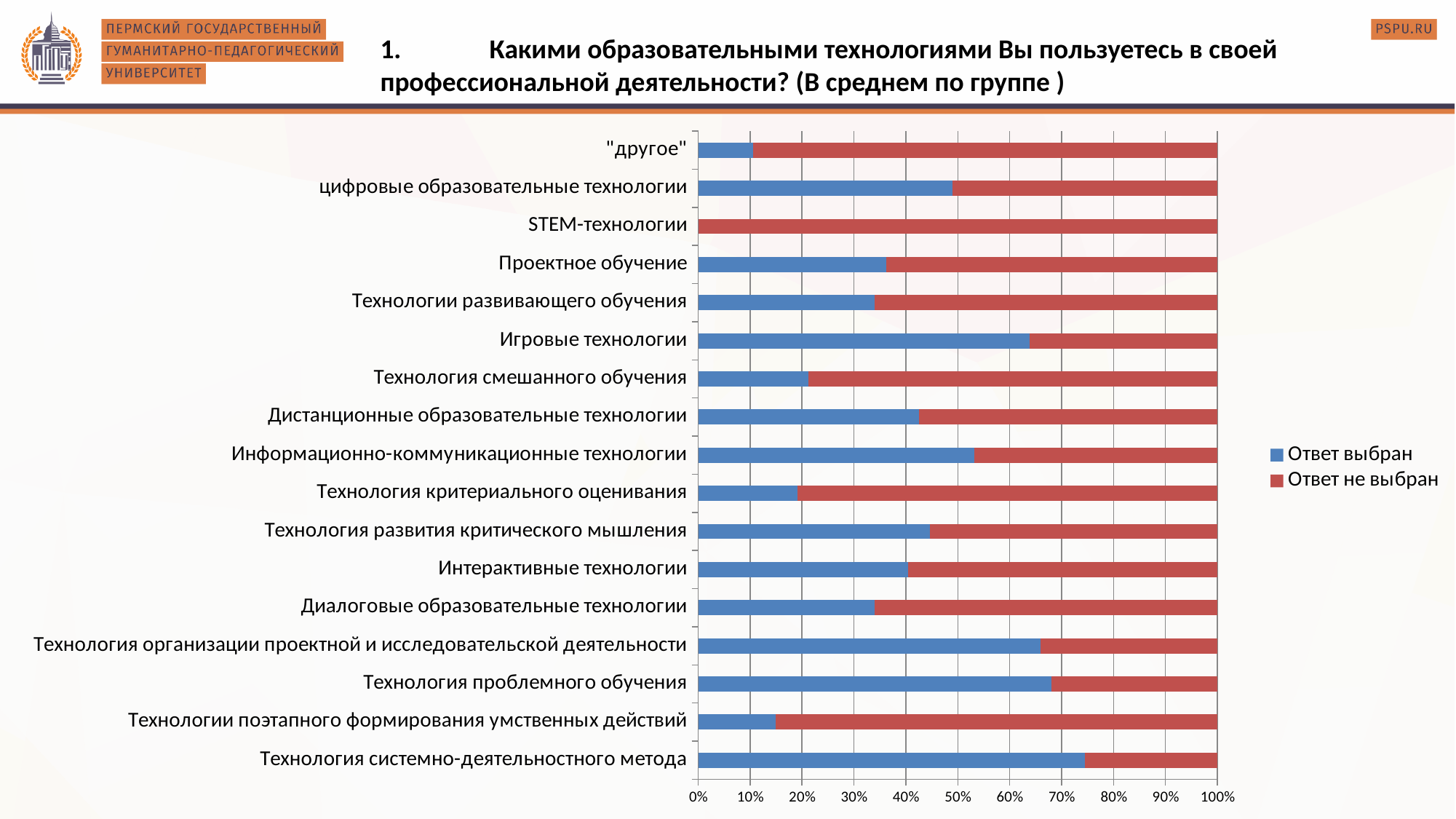
Which category has the smallest share of "Ответ выбран"? STEM-технологии What kind of chart is shown on the slide? bar chart Is the "Ответ выбран" share for Технология проблемного обучения greater or less than 60%? greater Which category has the largest share of "Ответ выбран"? Технология системно-деятельностного метода How many series does the legend list? 2 Is the "Ответ выбран" share for Технология смешанного обучения greater or less than 30%? less Is the "Ответ выбран" share for "другое" greater or less than 20%? less Which has a larger "Ответ выбран" share: Игровые технологии or Проектное обучение? Игровые технологии Which colour represents "Ответ не выбран" in the legend? red What is the total of the stacked bar for Интерактивные технологии? 100% How many categories (technologies) are plotted on the chart? 17